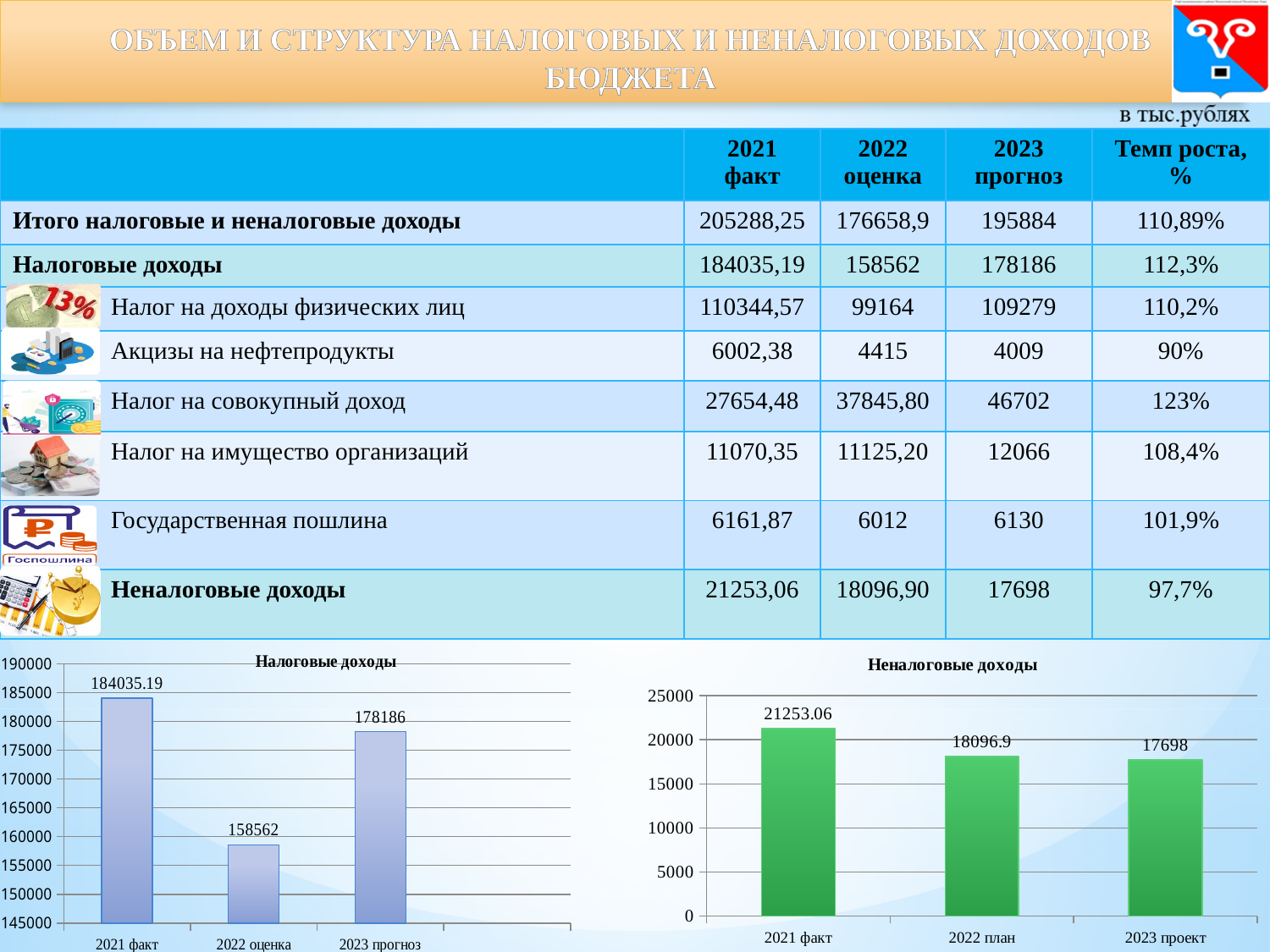
In the 'Неналоговые доходы' chart, what is the value for 2023 проект? 17698 In the 'Неналоговые доходы' chart, which category has the highest value? 2021 факт In the 'Неналоговые доходы' chart, what is the value for 2021 факт? 21253.06 What type of chart is the 'Неналоговые доходы' chart? bar chart In the 'Налоговые доходы' chart, what is the difference between the 2023 прогноз and 2022 оценка values? 19624 In the 'Неналоговые доходы' chart, is the value for 2022 план greater or less than 20000? less In the 'Неналоговые доходы' chart, do the values rise or fall from 2021 факт to 2023 проект? fall In the 'Налоговые доходы' chart, what is the value for 2022 оценка? 158562 In the 'Налоговые доходы' chart, what is the value for 2021 факт? 184035.19 In the 'Неналоговые доходы' chart, which is larger: the value for 2022 план or 2023 проект? 2022 план In the 'Налоговые доходы' chart, how many bars are plotted? 3 In the 'Налоговые доходы' chart, which category has the lowest value? 2022 оценка